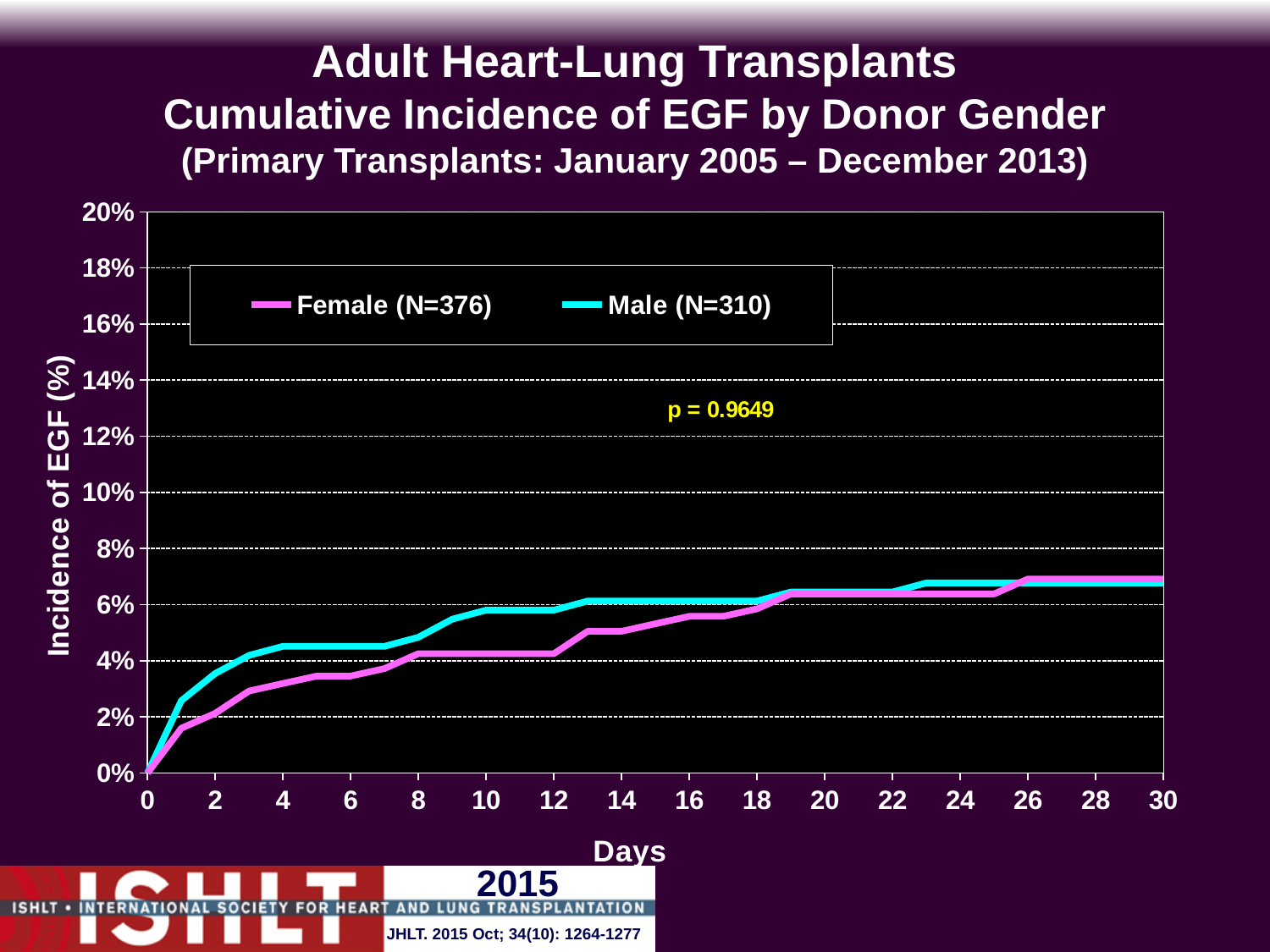
Do the cumulative incidence values for the Male series rise or fall as days increase? rise What p-value is printed on the chart? p = 0.9649 How many series does the legend list? 2 Is the value for the Female series at day 1 greater or less than 2%? less Is the value for the Male series at day 2 greater or less than 2%? greater At day 10, which series has the higher cumulative incidence of EGF, Female or Male? Male What are the two series named in the legend? Female (N=376) and Male (N=310) Is the value for the Female series at day 30 greater or less than 6%? greater What is the cumulative incidence of EGF for both series at day 0? 0% At day 4, which series has the higher cumulative incidence of EGF, Female or Male? Male What kind of chart is shown on the slide? line chart